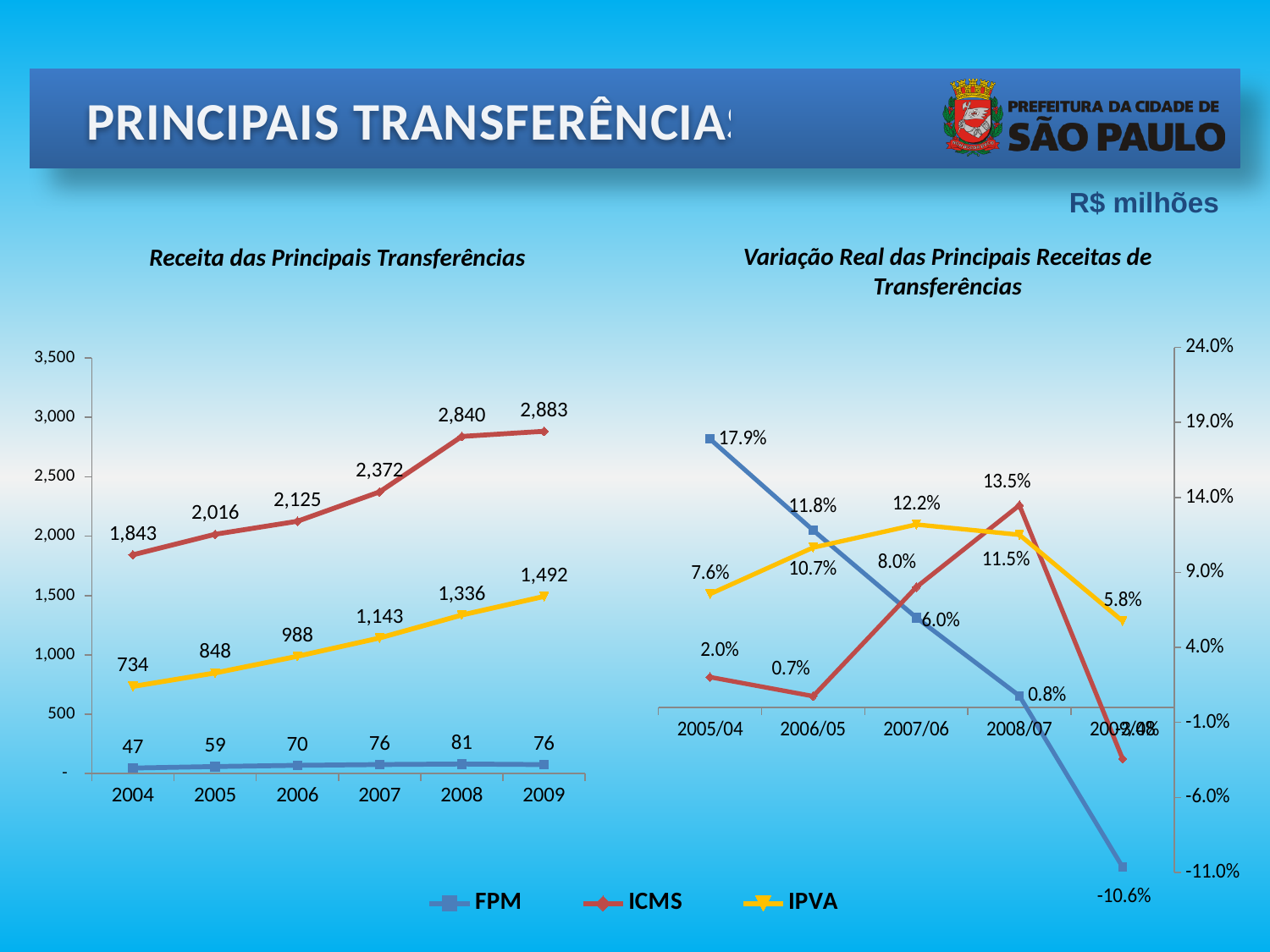
In the chart 'Receita das Principais Transferências', what is the difference between the ICMS values for 2009 and 2004? 1,040 In the chart 'Variação Real das Principais Receitas de Transferências', in which period is the IPVA value highest? 2007/06 In the chart 'Variação Real das Principais Receitas de Transferências', what is the ICMS value for 2008/07? 13.5% In the chart 'Receita das Principais Transferências', does the IPVA series rise or fall from 2004 to 2009? Rises What kind of chart is 'Variação Real das Principais Receitas de Transferências'? Line chart How many series does the legend list for the charts on the slide? 3 In the chart 'Receita das Principais Transferências', what is the IPVA value for 2004? 734 In the chart 'Receita das Principais Transferências', what is the ICMS value for 2009? 2,883 In the chart 'Variação Real das Principais Receitas de Transferências', what is the FPM value for 2005/04? 17.9% In the chart 'Receita das Principais Transferências', in which year is the FPM value highest? 2008 In the chart 'Receita das Principais Transferências', how many years are shown on the x axis? 6 In the chart 'Receita das Principais Transferências', which is larger: IPVA in 2007 or ICMS in 2004? ICMS in 2004